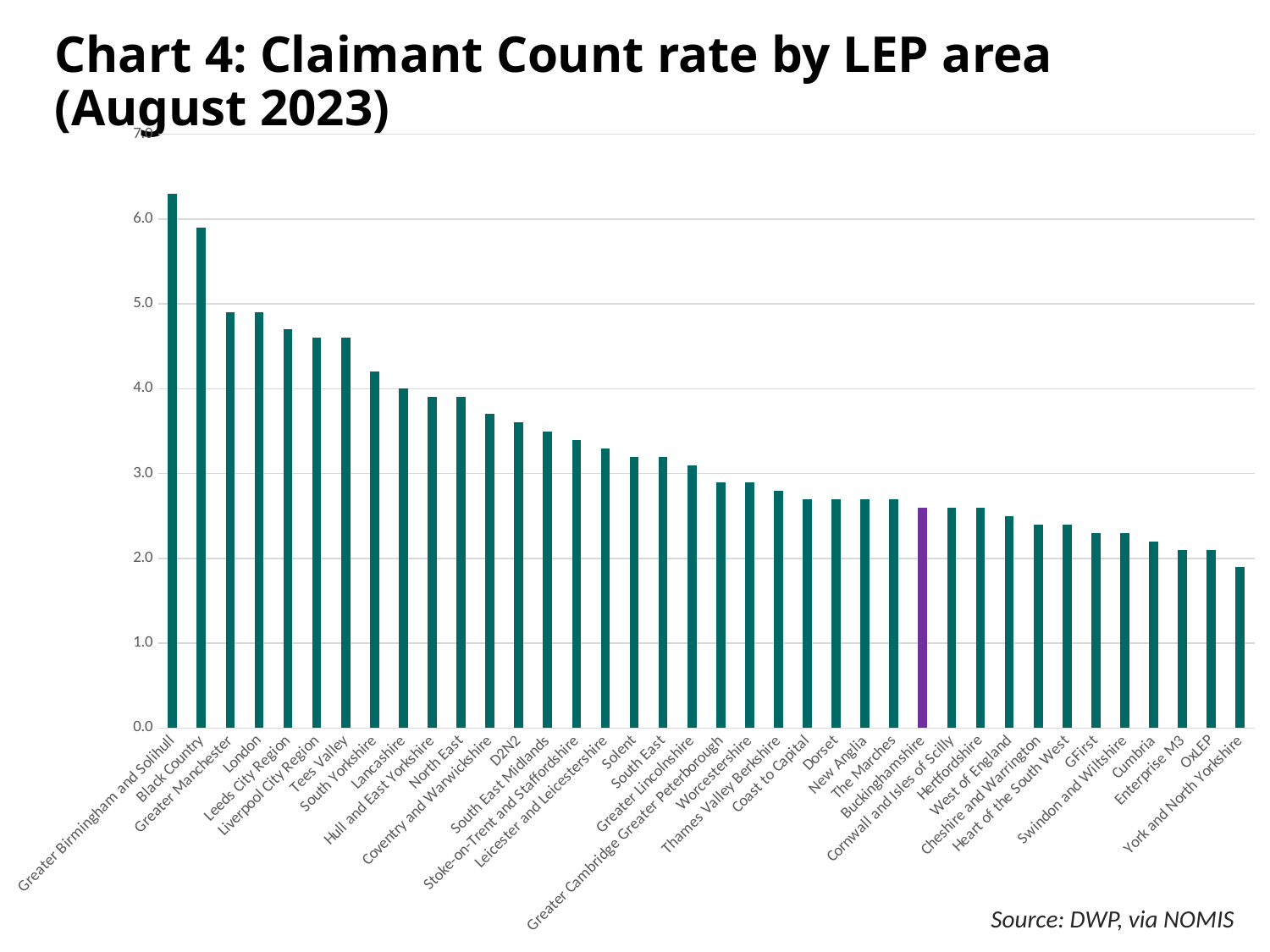
Which LEP area has the highest Claimant Count rate? Greater Birmingham and Solihull Which LEP area's bar is coloured purple rather than green? Buckinghamshire Do the values rise or fall moving from left to right along the x axis? fall Which has the larger Claimant Count rate, Black Country or Greater Manchester? Black Country Is the value for Greater Birmingham and Solihull greater or less than 6.0? greater Is the value for Tees Valley greater or less than 4.0? greater Is the value for Black Country greater or less than 5.0? greater Which has the larger Claimant Count rate, Lancashire or Dorset? Lancashire What kind of chart is shown on the slide? bar chart How many LEP areas are shown on the chart? 38 Which LEP area has the lowest Claimant Count rate? York and North Yorkshire